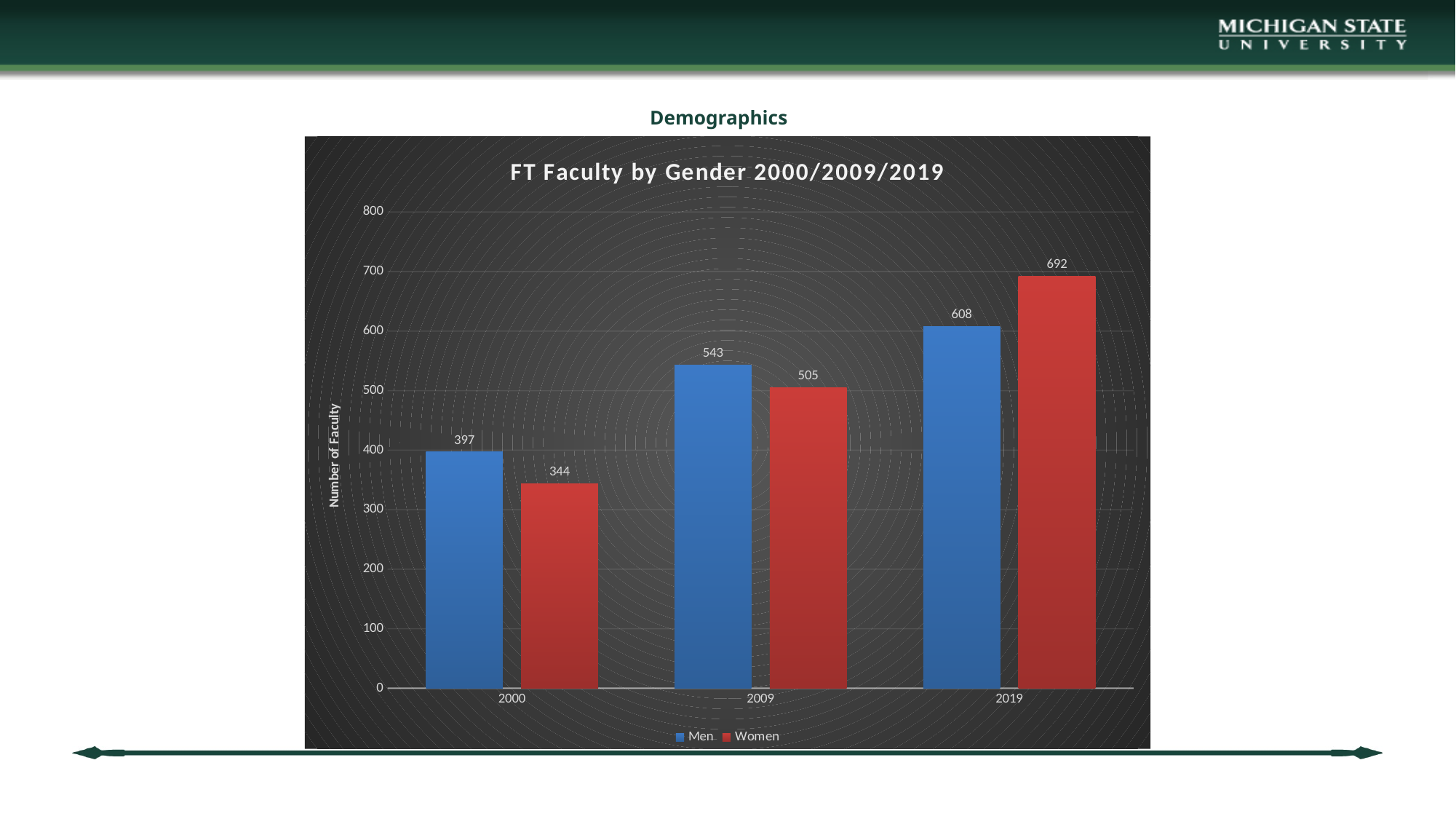
In which year is the number of women faculty highest? 2019 What kind of chart is shown? Bar chart What is the title of the chart? FT Faculty by Gender 2000/2009/2019 What is the difference between men and women faculty in 2009? 38 What is the number of men faculty in 2000? 397 In which year is the number of men faculty lowest? 2000 Does the number of men faculty rise or fall from 2000 to 2019? Rise How many series does the legend list? 2 What is the number of women faculty in 2009? 505 How many years are shown on the x axis? 3 In 2019, which is larger, the number of men or the number of women faculty? Women What is the number of women faculty in 2019? 692